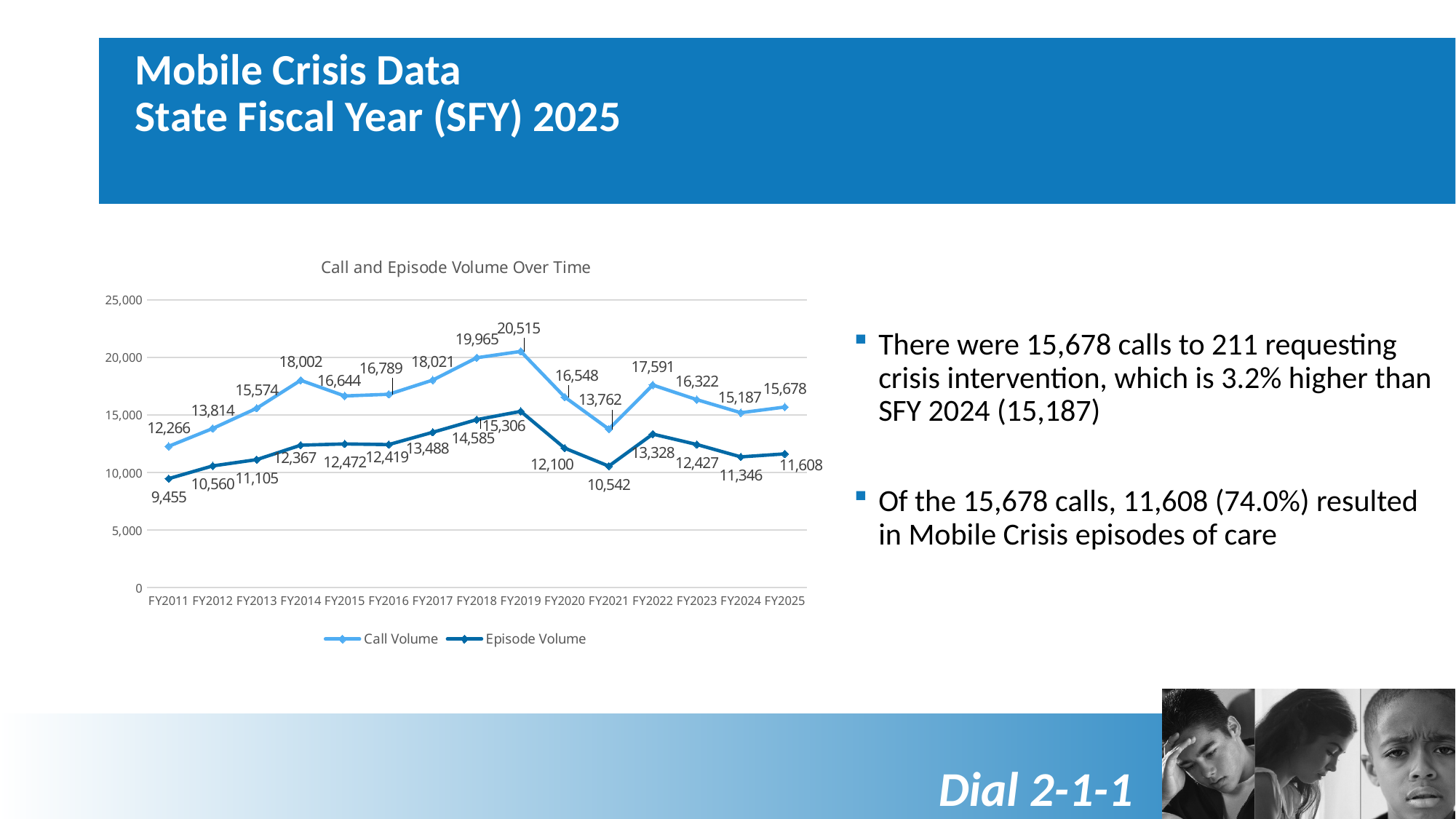
What is the Call Volume for FY2019? 20,515 In which fiscal year is the Call Volume highest? FY2019 What kind of chart is shown on the slide? Line chart In which fiscal year is the Episode Volume lowest? FY2011 Which fiscal year has the larger Call Volume, FY2022 or FY2023? FY2022 What is the Episode Volume for FY2011? 9,455 How many series does the legend of the chart list? 2 What is the title of the chart? Call and Episode Volume Over Time How many fiscal years are plotted along the x axis of the chart? 15 What is the difference between the Call Volume and the Episode Volume in FY2025? 4,070 Is the Call Volume for FY2021 greater or less than 15,000? less What is the Episode Volume for FY2018? 14,585